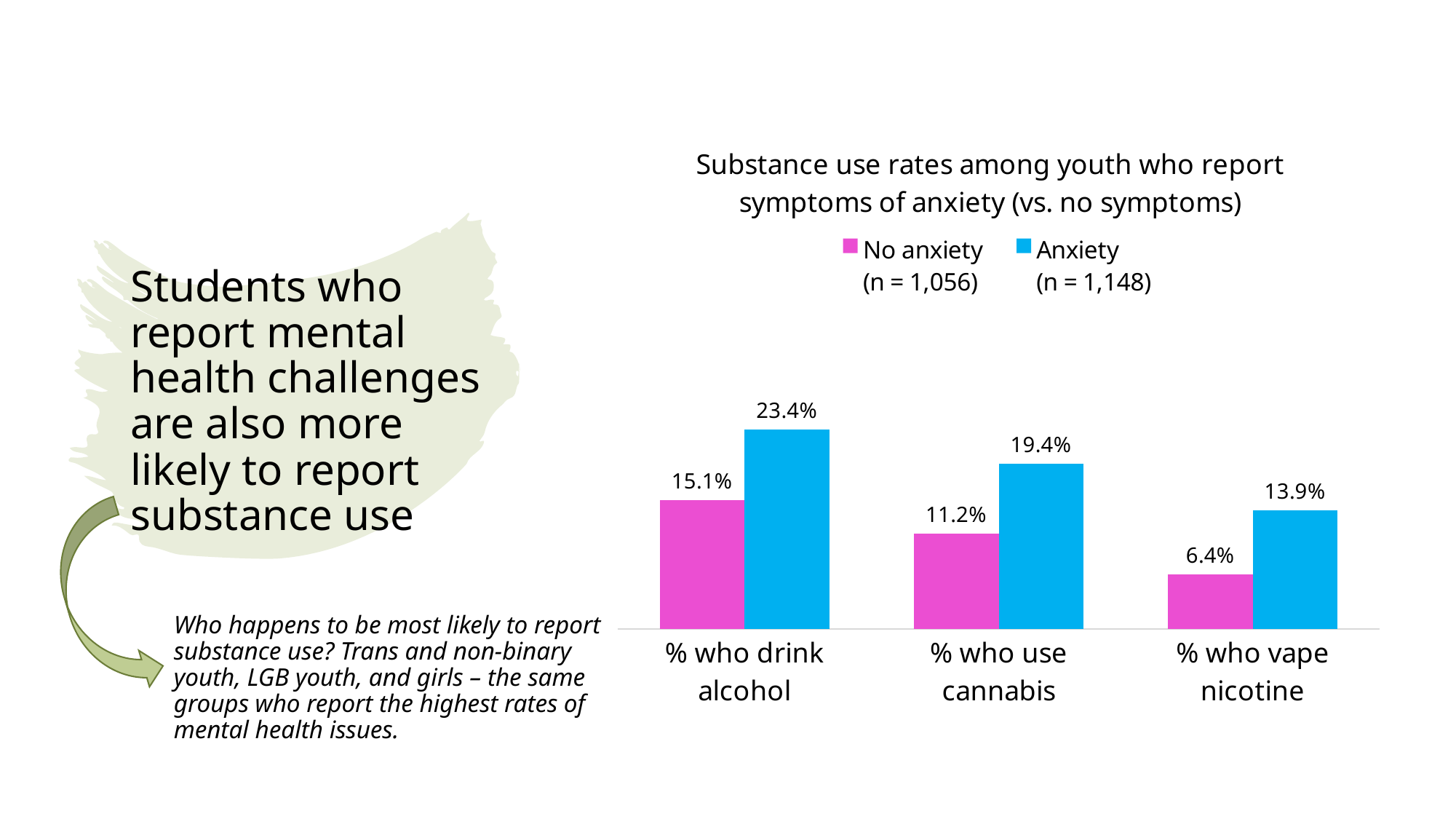
What percentage of youth with anxiety report using cannabis? 19.4% What is the difference between the Anxiety and No anxiety values for '% who vape nicotine'? 7.5% How many series does the chart legend list? 2 Which category has the highest value for the Anxiety series? % who drink alcohol Which category has the lowest value for the No anxiety series? % who vape nicotine How many categories are shown on the x axis of the chart? 3 What percentage of youth with no anxiety report drinking alcohol? 15.1% For '% who use cannabis', which group has the larger value, Anxiety or No anxiety? Anxiety What is the difference between the Anxiety and No anxiety values for '% who drink alcohol'? 8.3% What kind of chart is shown on the slide? Bar chart What is the value for the No anxiety group for '% who vape nicotine'? 6.4% What is the sample size (n) for the Anxiety group shown in the legend? 1,148